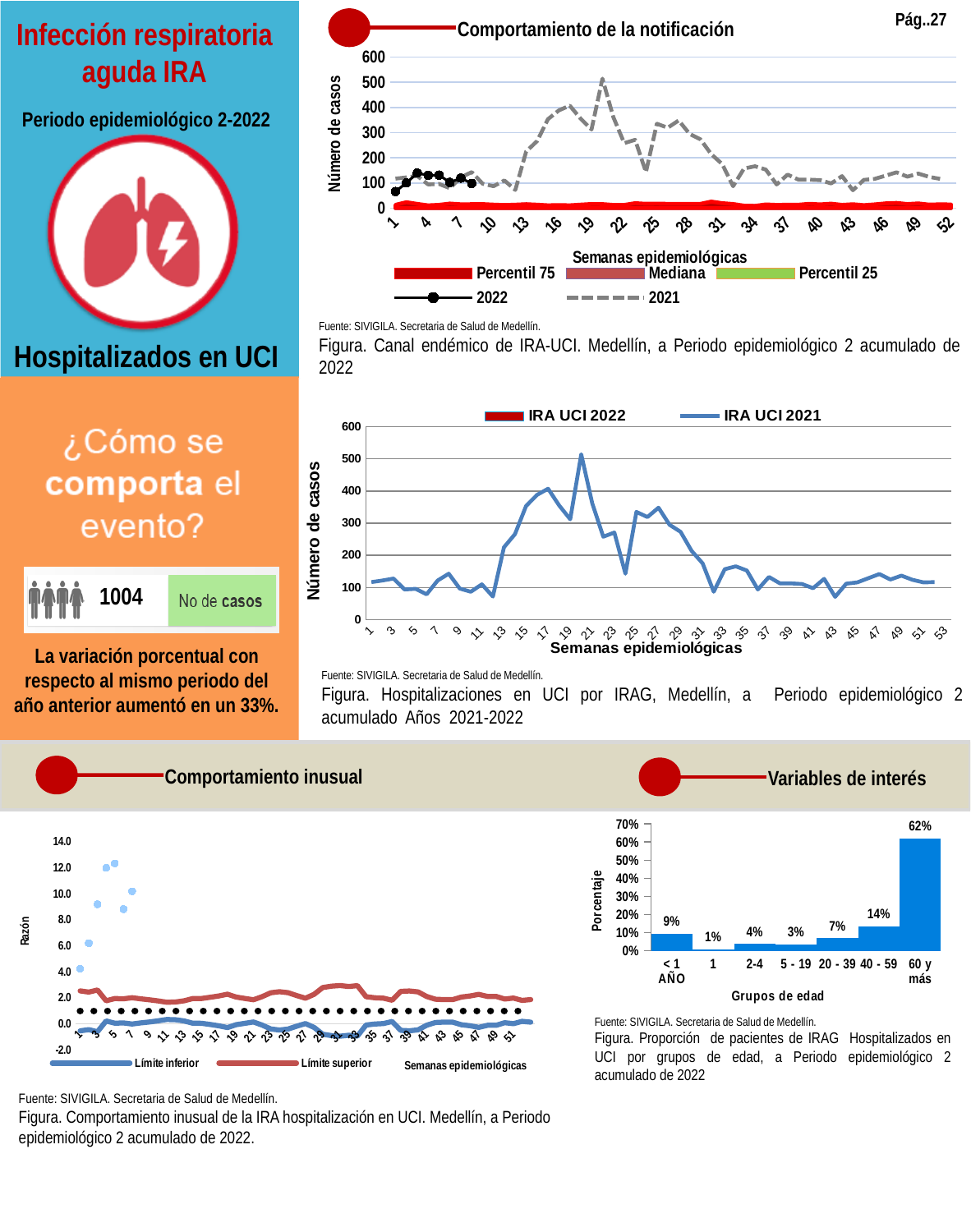
In the 'Variables de interés' bar chart, what percentage is shown for the '60 y más' age group? 62% What kind of chart is used in the 'Variables de interés' section? Bar chart How many series does the legend of the 'Comportamiento de la notificación' chart (Canal endémico de IRA-UCI) list? 5 In the 'Variables de interés' bar chart, what percentage is shown for the '< 1 AÑO' age group? 9% In the 'Variables de interés' bar chart, which has a larger percentage: '< 1 AÑO' or '20 - 39'? < 1 AÑO In the 'Variables de interés' bar chart, what is the difference between the percentages for '60 y más' and '40 - 59'? 48% In the 'Variables de interés' bar chart, which age group has the highest percentage? 60 y más In the 'Variables de interés' bar chart, what percentage is shown for the '40 - 59' age group? 14% In the 'Variables de interés' bar chart, which age group has the lowest percentage? 1 How many series does the legend of the 'Hospitalizaciones en UCI por IRAG' chart list? 2 How many age groups are shown in the 'Variables de interés' bar chart? 7 In the 'Hospitalizaciones en UCI por IRAG' chart, is the peak value of the IRA UCI 2021 line greater or less than 400? greater